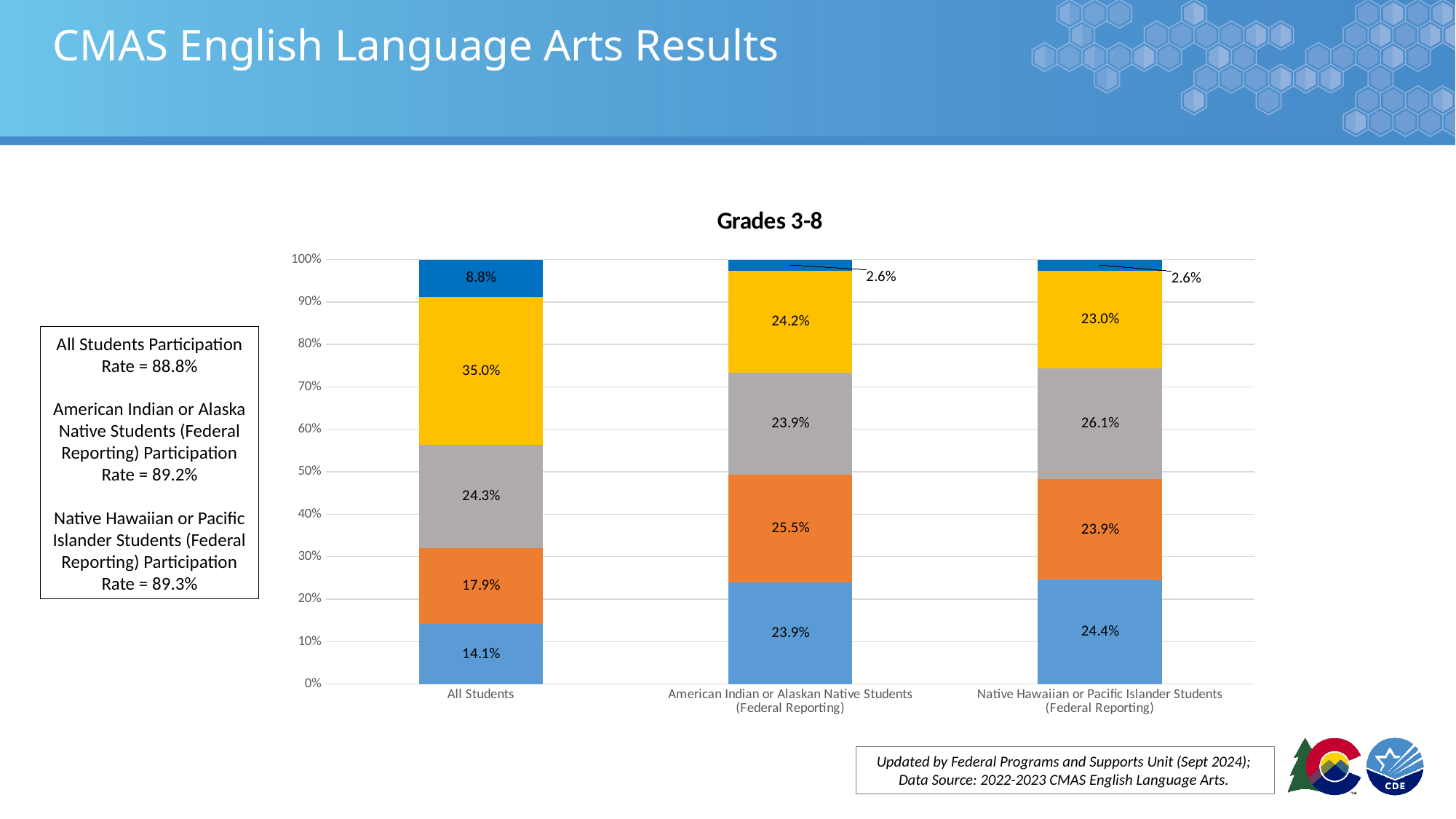
What is the title of the chart? Grades 3-8 Which category has the smallest bottom (light blue) segment? All Students What is the value of the gray segment for Native Hawaiian or Pacific Islander Students (Federal Reporting)? 26.1% What kind of chart is shown on the slide? Stacked bar chart How many categories are shown along the x axis of the chart? 3 Which category has the largest yellow segment? All Students What is the value of the top (dark blue) segment for All Students? 8.8% What is the value of the yellow segment for American Indian or Alaskan Native Students (Federal Reporting)? 24.2% What is the difference between the orange segment for American Indian or Alaskan Native Students (Federal Reporting) and the orange segment for All Students? 7.6% What is the value of the top (dark blue) segment for Native Hawaiian or Pacific Islander Students (Federal Reporting)? 2.6% Is the gray segment larger for All Students or for Native Hawaiian or Pacific Islander Students (Federal Reporting)? Native Hawaiian or Pacific Islander Students (Federal Reporting) What is the value of the bottom (light blue) segment for All Students? 14.1%